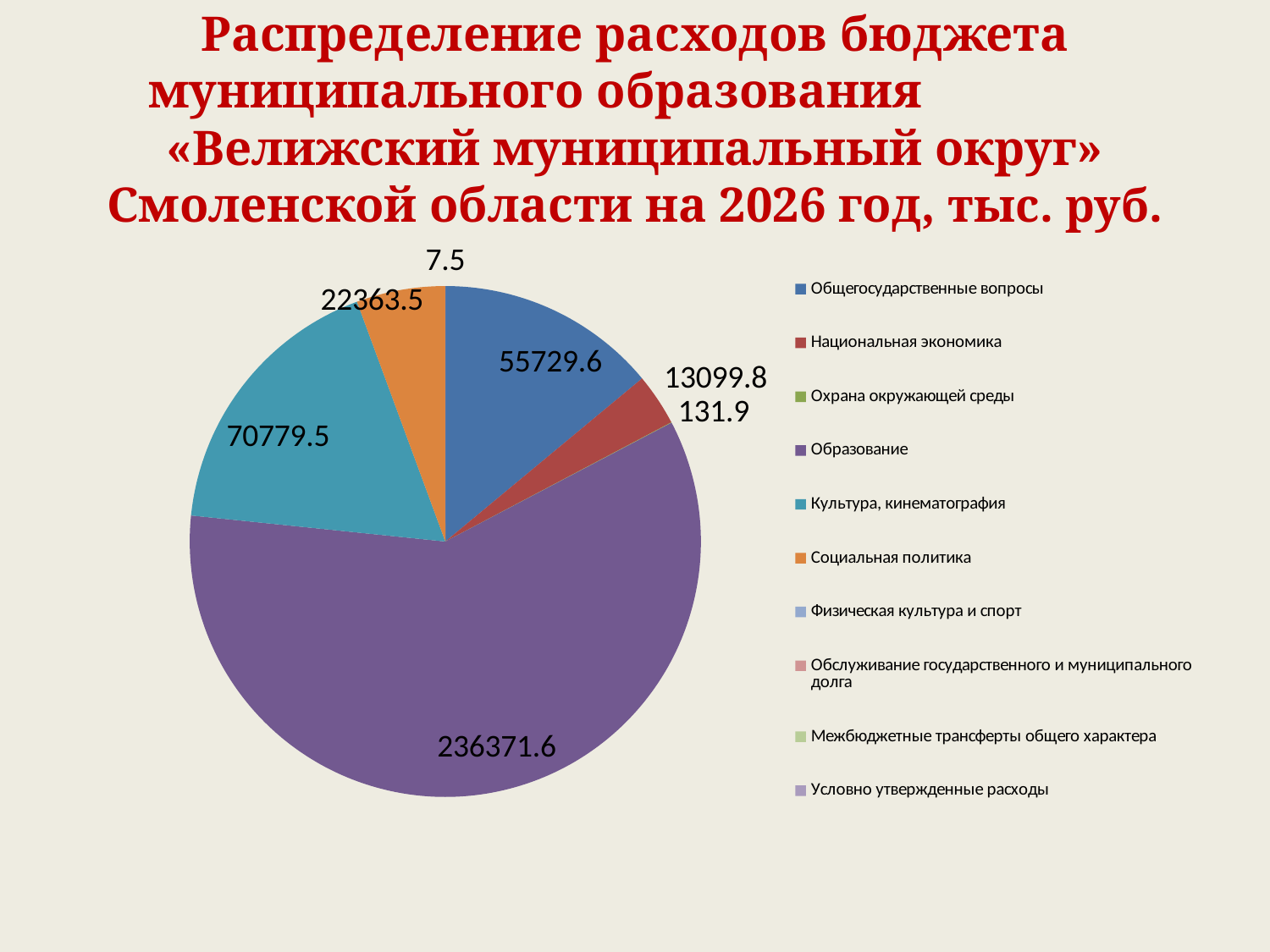
What is the value for Общегосударственные вопросы? 55729.6 Which is larger, Культура, кинематография or Общегосударственные вопросы? Культура, кинематография What colour is the slice for Образование? purple What is the difference between the values for Социальная политика and Национальная экономика? 9263.7 What kind of chart is shown on the slide? pie chart What is the value for Культура, кинематография? 70779.5 Which category has the largest slice of the pie? Образование What is the difference between the values for Культура, кинематография and Общегосударственные вопросы? 15049.9 What is the value for Образование? 236371.6 How many entries does the legend list? 10 What is the value for Социальная политика? 22363.5 What is the value for Национальная экономика? 13099.8